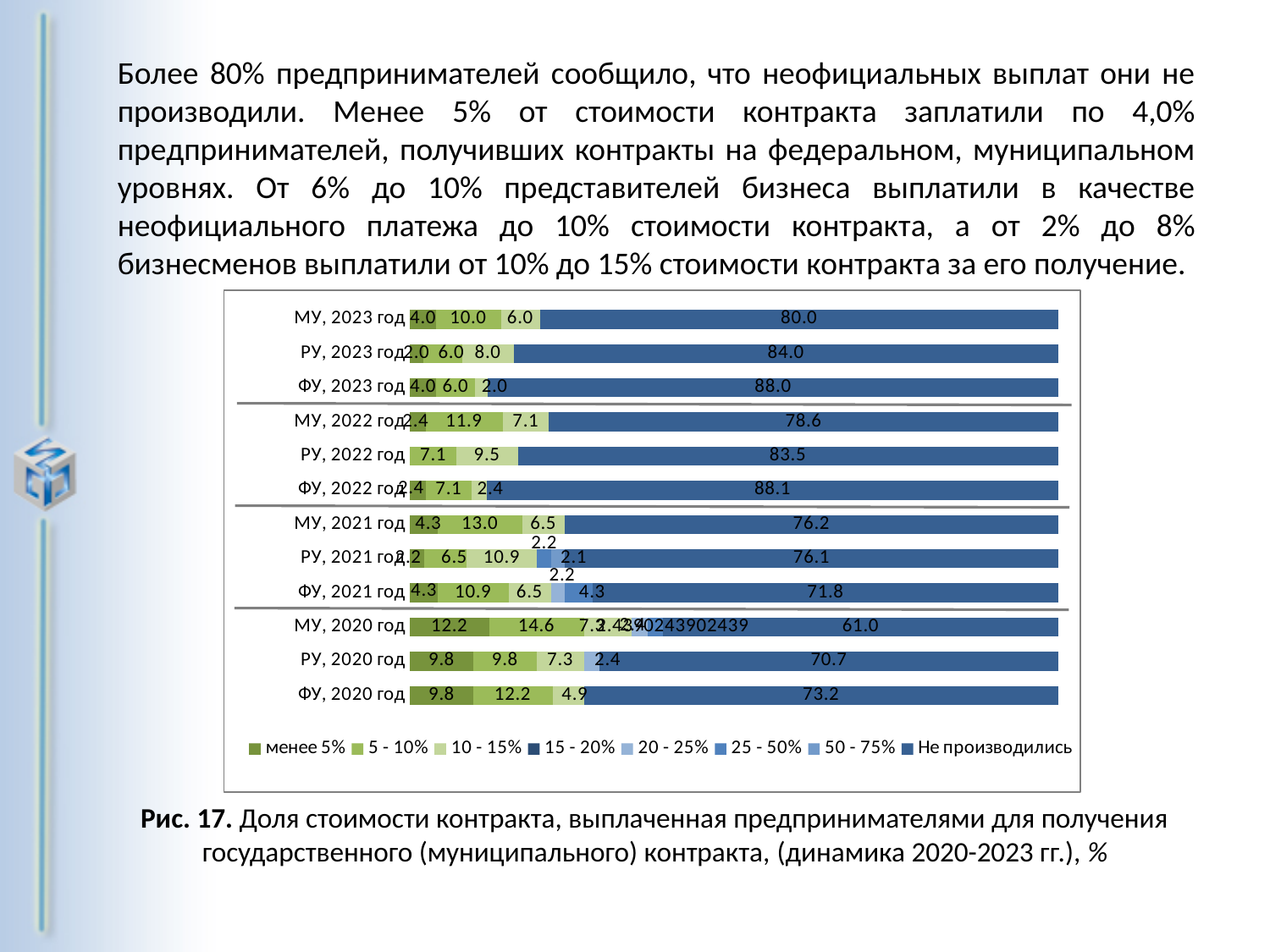
How many series does the legend list? 8 What is the value of the 'Не производились' segment for МУ, 2023 год? 80.0 Which has the larger '5 - 10%' value: МУ, 2021 год or МУ, 2023 год? МУ, 2021 год What is the value of the '5 - 10%' segment for МУ, 2021 год? 13.0 Which category has the lowest value for the 'Не производились' series? МУ, 2020 год For the МУ categories, does the 'Не производились' value rise or fall from 2020 to 2023? rise How many categories (bars) are plotted in the chart? 12 What is the value of the 'менее 5%' segment for ФУ, 2020 год? 9.8 What is the difference between the 'Не производились' values for ФУ, 2023 год and МУ, 2023 год? 8.0 What is the value of the 'Не производились' segment for РУ, 2022 год? 83.5 What kind of chart is shown on the slide? bar chart What is the last entry in the chart's legend? Не производились